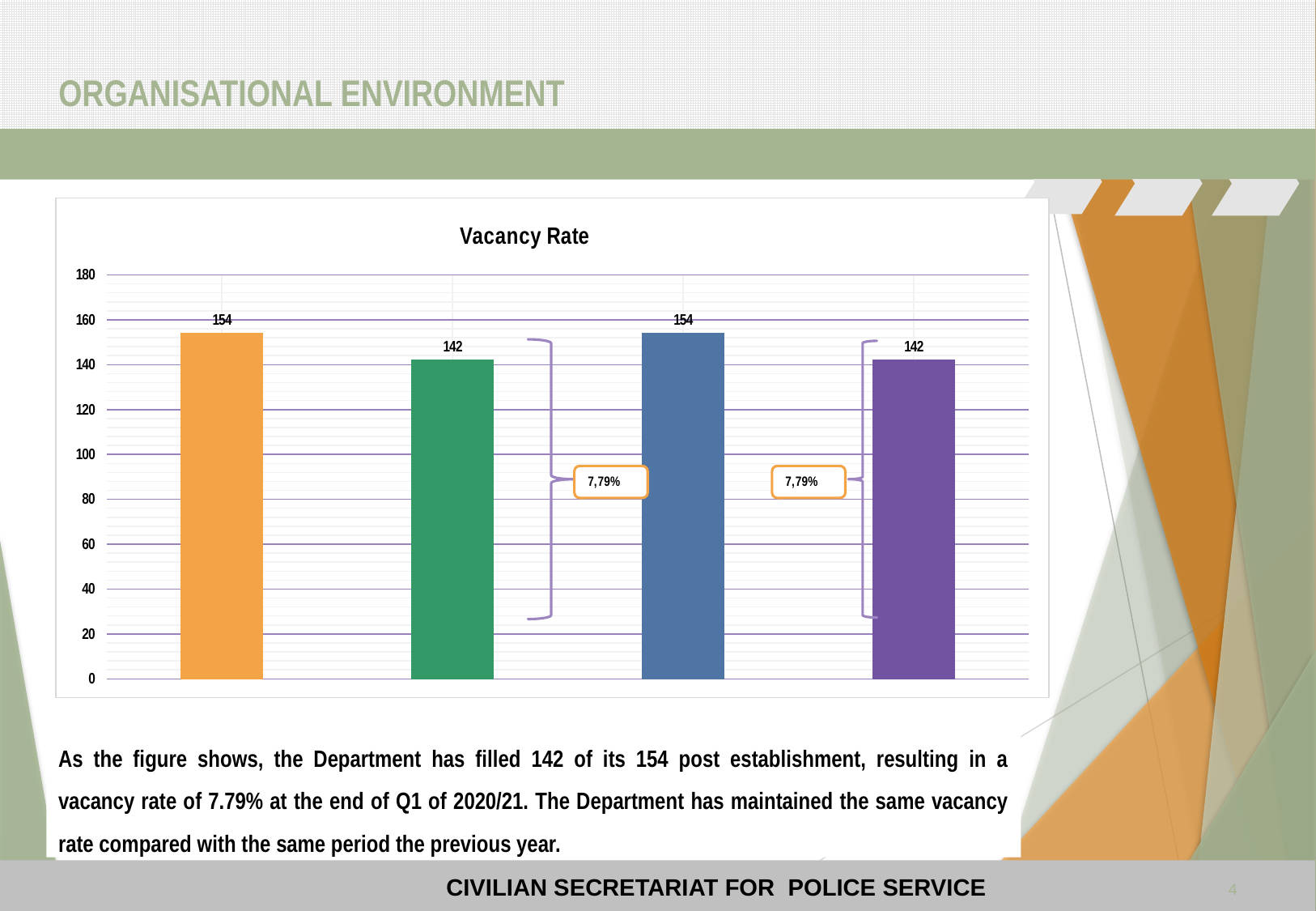
How many bars are plotted in the chart? 4 What is the title of the chart? Vacancy Rate Is the value of the purple bar greater or less than 120? greater What kind of chart is shown on the slide? bar chart What is the value of the second (green) bar? 142 What is the difference between the value of the blue bar and the value of the purple bar? 12 What percentage is shown in the callout boxes between the bars? 7,79% Which is larger, the orange bar or the green bar? the orange bar What is the value of the fourth (purple) bar? 142 What is the value of the third (blue) bar? 154 Is the value of the orange bar greater or less than 160? less What is the value of the first (orange) bar? 154